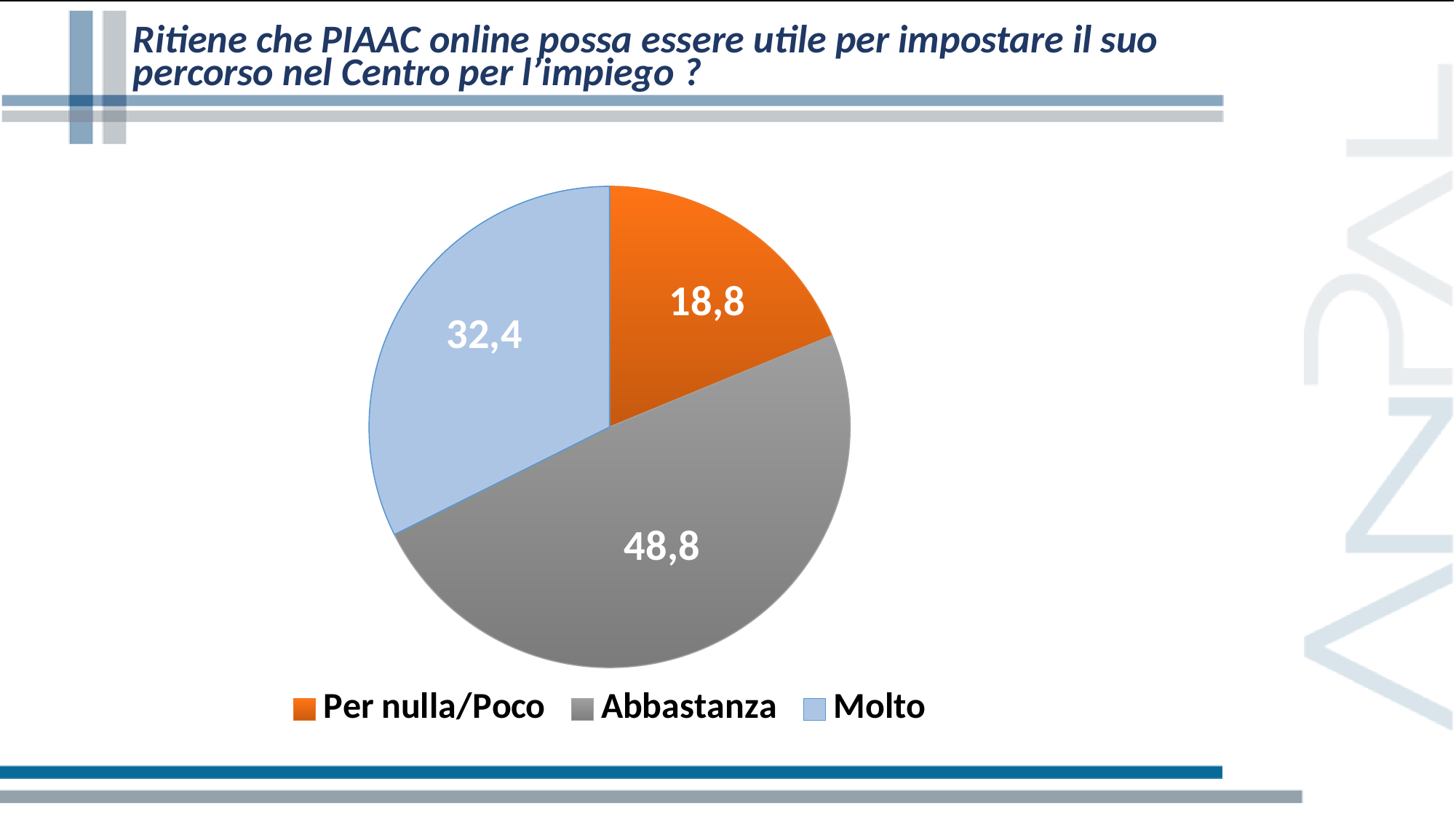
How many slices does the pie chart have? 3 What is the difference between the values for Molto and Per nulla/Poco? 13,6 Which category has the smallest slice? Per nulla/Poco What kind of chart is shown on the slide? Pie chart What is the value for Per nulla/Poco? 18,8 What is the value for Abbastanza? 48,8 What is the difference between the values for Abbastanza and Molto? 16,4 Which category has the largest slice? Abbastanza What is the value for Molto? 32,4 What are the three legend entries of the chart? Per nulla/Poco, Abbastanza, Molto Which is larger, the value for Molto or the value for Per nulla/Poco? Molto Which colour represents Molto in the pie chart? Light blue